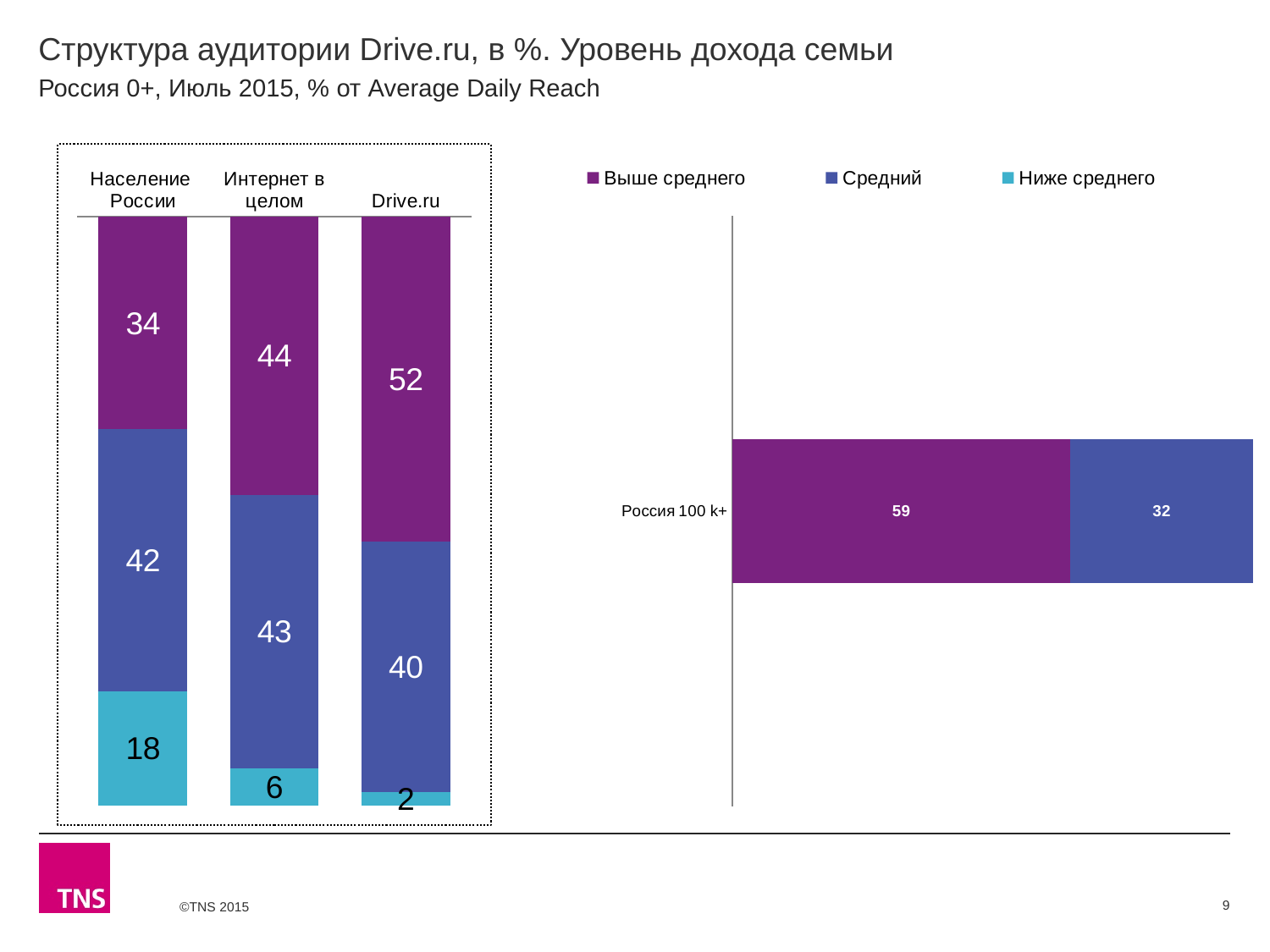
In the left chart, is the 'Средний' value larger for Население России or for Drive.ru? Население России In the left chart, how many categories are shown? 3 How many series does the legend list? 3 In the left chart, what is the difference between the 'Выше среднего' values for Drive.ru and Население России? 18 In the left chart, what is the total of the stacked bar for Интернет в целом? 93 In the left chart, what is the value of the 'Ниже среднего' segment for Население России? 18 In the right chart, what is the 'Средний' value for Россия 100 k+? 32 In the left chart, what is the value of the 'Выше среднего' segment for Drive.ru? 52 In the left chart, which category has the highest 'Выше среднего' value? Drive.ru In the right chart, what is the 'Выше среднего' value for Россия 100 k+? 59 In the left chart, which category has the lowest 'Ниже среднего' value? Drive.ru In the left chart, what is the value of the 'Средний' segment for Интернет в целом? 43